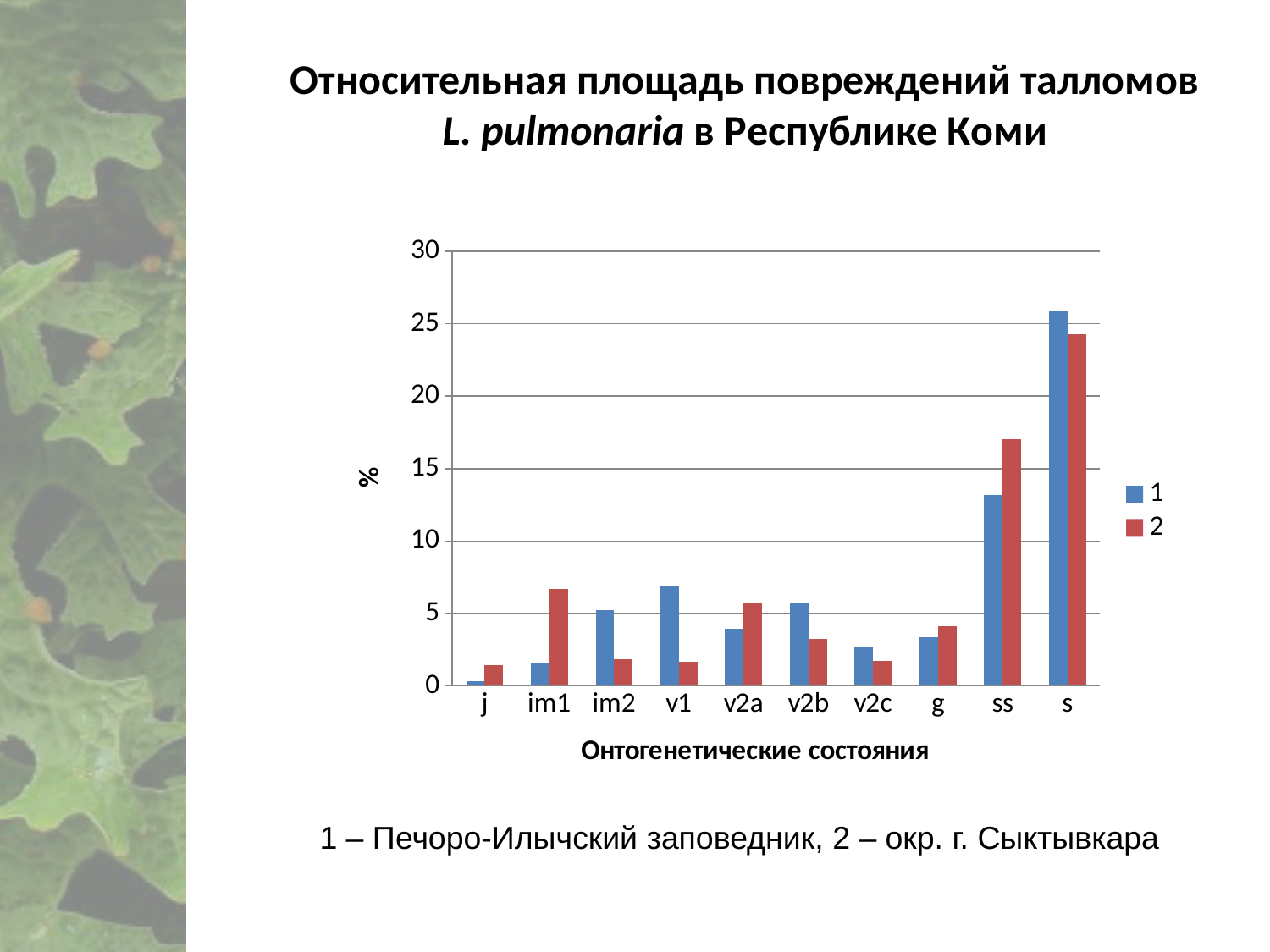
For series 1, which category has the highest value? s For series 2, which category has the highest value? s What kind of chart is shown on the slide? bar chart What is the title of the x axis? Онтогенетические состояния Is the value for series 1 at ss greater or less than 15? less Is the value for series 2 at ss greater or less than 15? greater Is the value for series 1 at s greater or less than 25? greater How many series does the legend list? 2 For series 1, which category has the lowest value? j At category im1, which series has the larger value, 1 or 2? 2 How many ontogenetic state categories are shown on the x axis? 10 At category v1, which series has the larger value, 1 or 2? 1